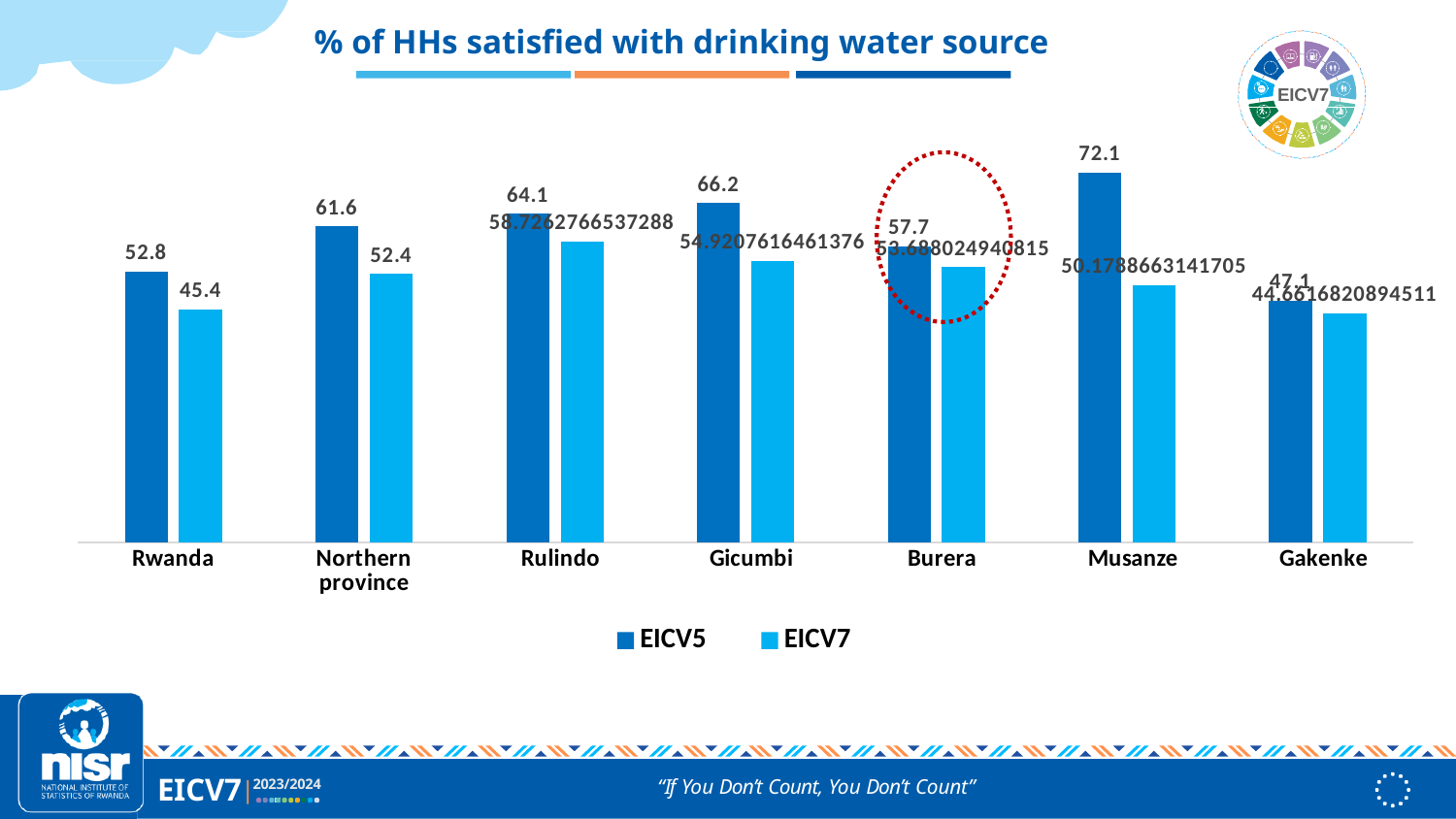
How many categories are shown on the x axis? 7 What is the EICV5 value for Musanze? 72.1 How many series does the legend list? 2 Which category has the highest EICV5 value? Musanze What is the EICV7 value for Rwanda? 45.4 What is the difference between the EICV5 and EICV7 values for Northern province? 9.2 What is the title of the chart? % of HHs satisfied with drinking water source What type of chart is shown on the slide? bar chart Which category has the lowest EICV5 value? Gakenke What is the EICV7 value for Northern province? 52.4 Which is larger, the EICV5 value for Gicumbi or the EICV5 value for Burera? Gicumbi What is the EICV5 value for Rwanda? 52.8